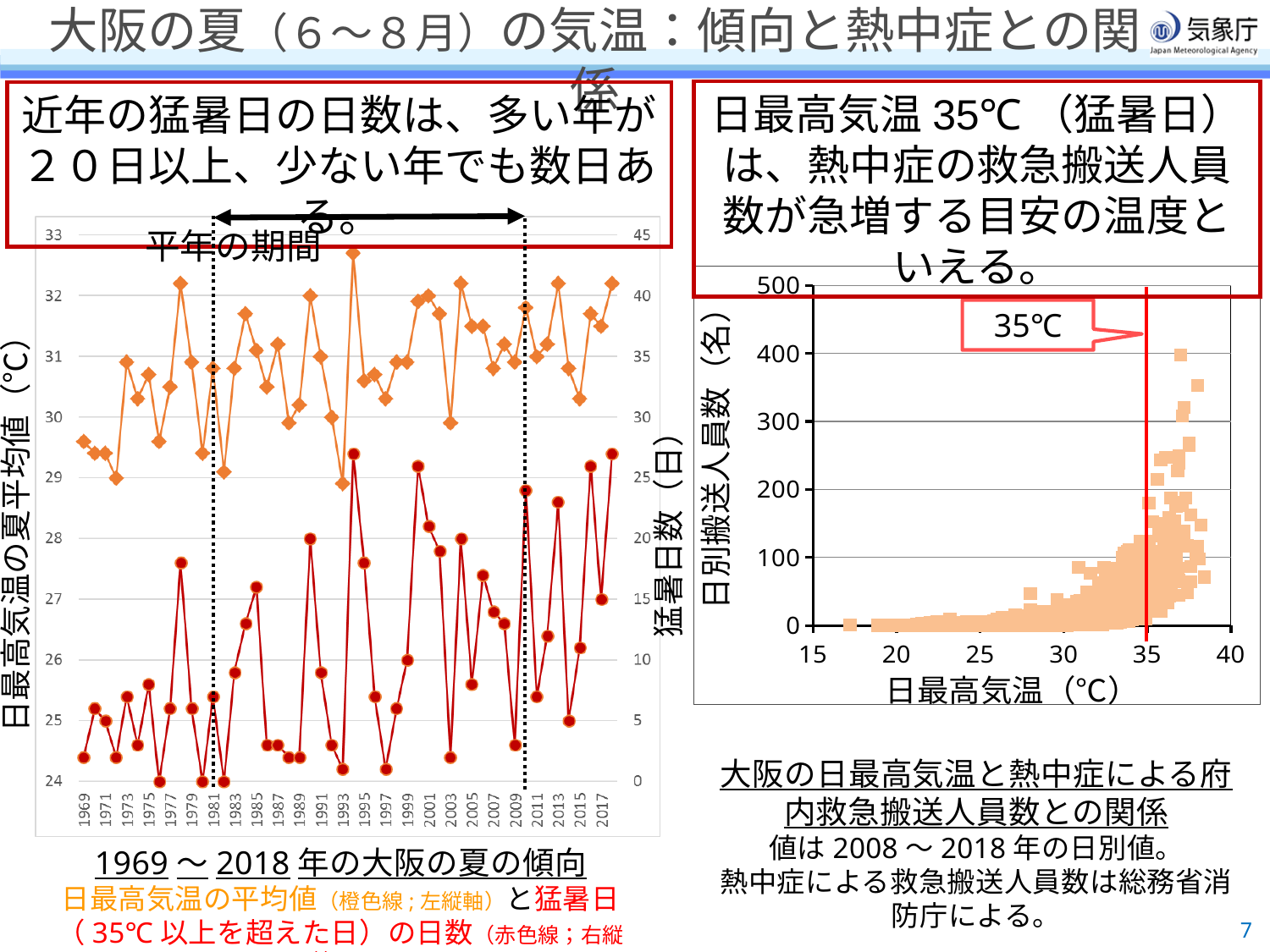
In the left chart, which year has the higher number of extremely hot days (red line), 2010 or 2003? 2010 What kind of chart is the left chart showing Osaka's summer trend from 1969 to 2018? line chart What kind of chart is the right chart showing the relationship between daily maximum temperature and heatstroke emergency transports? scatter chart In the right chart, at what temperature is the red vertical reference line drawn? 35℃ In the left chart, is the number of extremely hot days (red line, right axis) in 1994 greater or less than 20? greater In the left chart, is the number of extremely hot days (red line, right axis) in 2003 greater or less than 5? less In the left chart, is the average daily maximum temperature (orange line, left axis) in 1994 greater or less than 32°C? greater In the right chart, do the numbers of emergency transports generally rise or fall as daily maximum temperature increases along the x axis? rise In the left chart, what is the highest value shown on the right vertical axis (猛暑日数)? 45